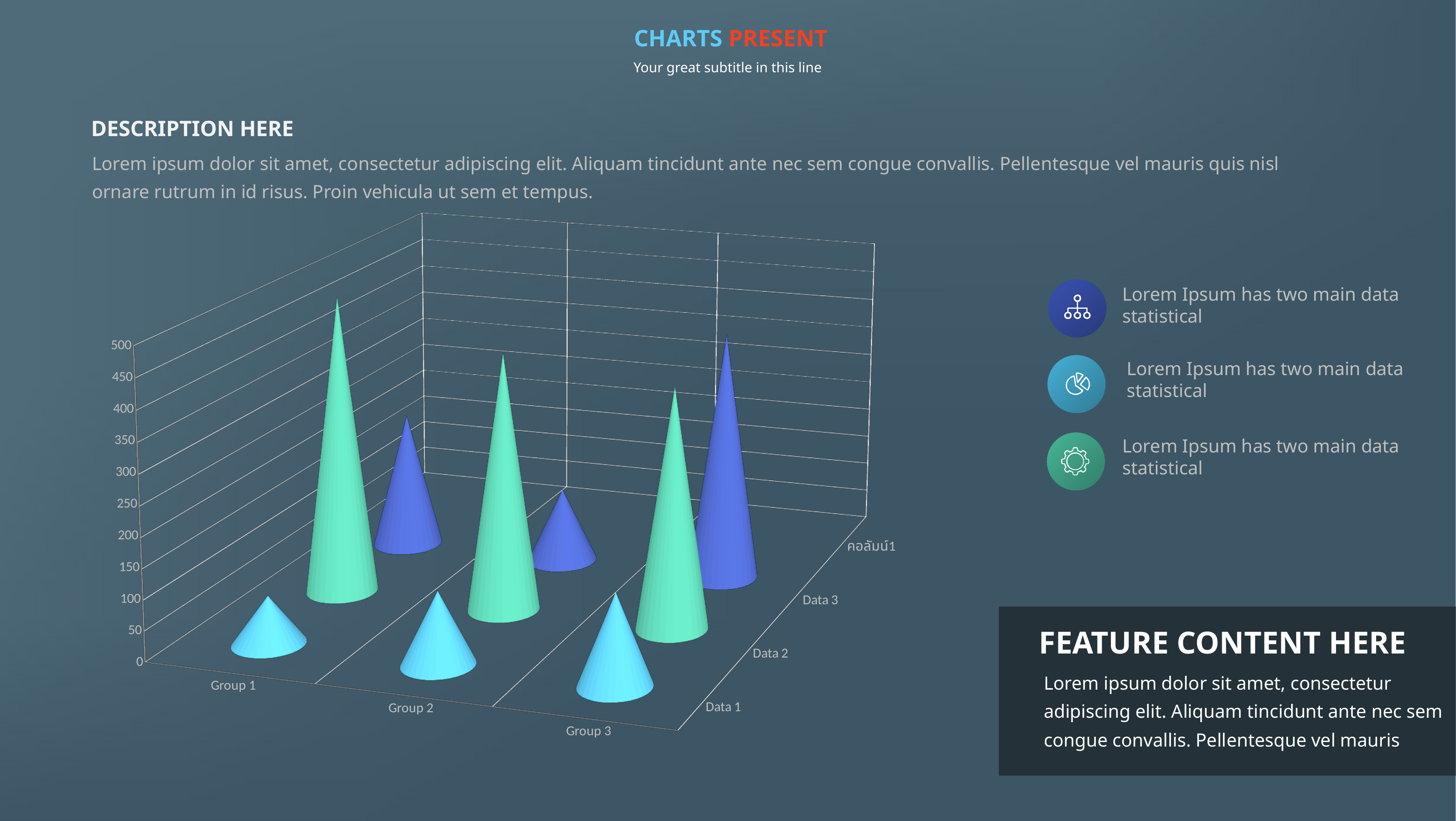
What colour are the cones of the Data 1 series? light blue (cyan) What is the highest value shown on the vertical axis of the chart? 500 How many groups are labelled along the horizontal axis of the chart? 3 Which group has the tallest cone in the Data 2 series? Group 1 Which group has the shortest cone in the Data 3 series? Group 2 What kind of chart is shown on the slide? bar chart Is the Data 2 value for Group 1 greater or less than 300? greater For Group 1, which is larger: the Data 2 value or the Data 3 value? Data 2 Which group has the smallest cone in the Data 1 series? Group 1 For Group 3, which is larger: the Data 1 value or the Data 3 value? Data 3 Which group has the tallest cone in the Data 3 series? Group 3 Is the Data 1 value for Group 1 greater or less than 300? less